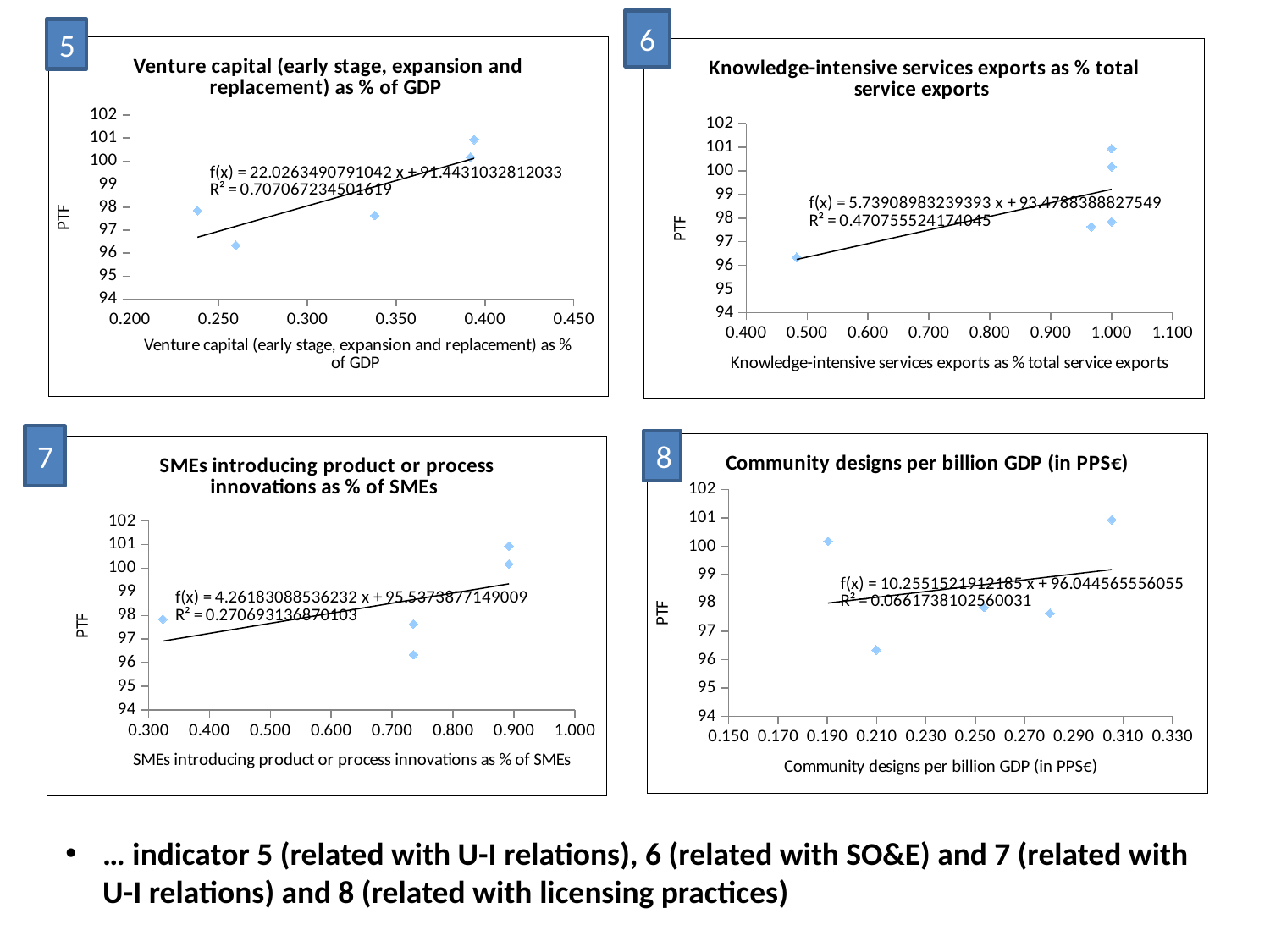
In chart 5, 'Venture capital (early stage, expansion and replacement) as % of GDP', what is the R² value shown for the trendline? 0.707067234501619 What is the label on the vertical axis of chart 5, 'Venture capital (early stage, expansion and replacement) as % of GDP'? PTF In chart 8, 'Community designs per billion GDP (in PPS€)', does the trendline rise or fall as the x value increases? Rise In chart 8, 'Community designs per billion GDP (in PPS€)', is the PTF value of the point near 0.210 greater or less than 97? less Which of the four charts has the highest R² value for its trendline? Chart 5, Venture capital (early stage, expansion and replacement) as % of GDP In chart 8, 'Community designs per billion GDP (in PPS€)', what is the R² value shown for the trendline? 0.0661738102560031 In chart 6, 'Knowledge-intensive services exports as % total service exports', is the PTF value of the leftmost point (near 0.500) greater or less than 97? less Which of the four charts has the lowest R² value for its trendline? Chart 8, Community designs per billion GDP (in PPS€) In chart 7, 'SMEs introducing product or process innovations as % of SMEs', what is the R² value shown for the trendline? 0.270693136870103 In chart 6, 'Knowledge-intensive services exports as % total service exports', what is the R² value shown for the trendline? 0.470755524174045 In chart 7, 'SMEs introducing product or process innovations as % of SMEs', how many data points are plotted? 5 What kind of chart is chart 5, 'Venture capital (early stage, expansion and replacement) as % of GDP'? Scatter chart